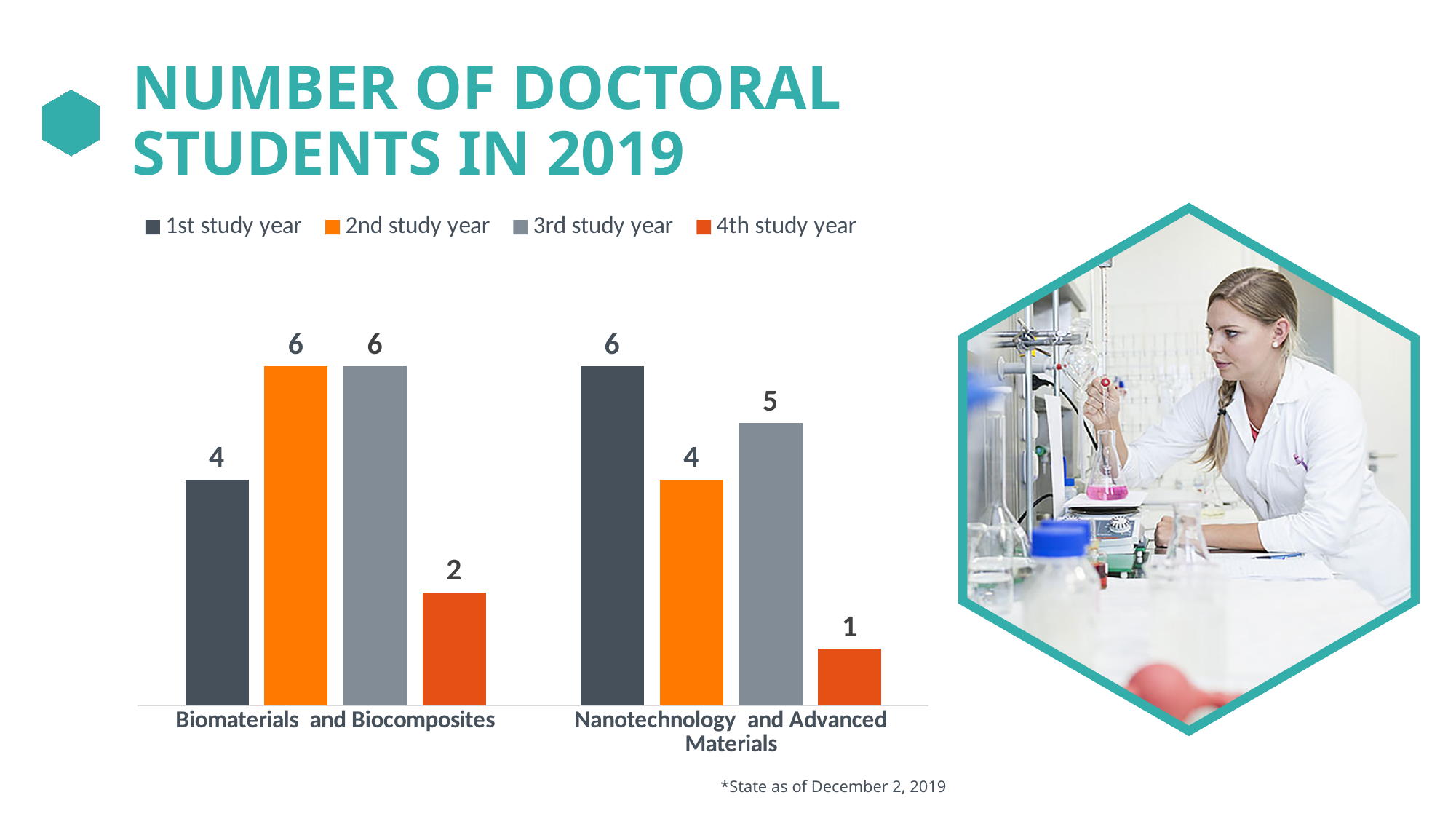
How many 4th study year doctoral students are in Biomaterials and Biocomposites? 2 Which study year has the most doctoral students in Nanotechnology and Advanced Materials? 1st study year Which is larger: the 2nd study year value for Biomaterials and Biocomposites or for Nanotechnology and Advanced Materials? Biomaterials and Biocomposites How many series does the legend list? 4 What is the difference between the 1st study year and 4th study year values for Nanotechnology and Advanced Materials? 5 How many categories are shown on the x axis? 2 What is the total number of doctoral students across all four study years in Biomaterials and Biocomposites? 18 How many 3rd study year doctoral students are in Nanotechnology and Advanced Materials? 5 What is the title of the chart on the slide? NUMBER OF DOCTORAL STUDENTS IN 2019 Which study year has the fewest doctoral students in Nanotechnology and Advanced Materials? 4th study year What kind of chart is shown on the slide? Bar chart How many 1st study year doctoral students are in Biomaterials and Biocomposites? 4